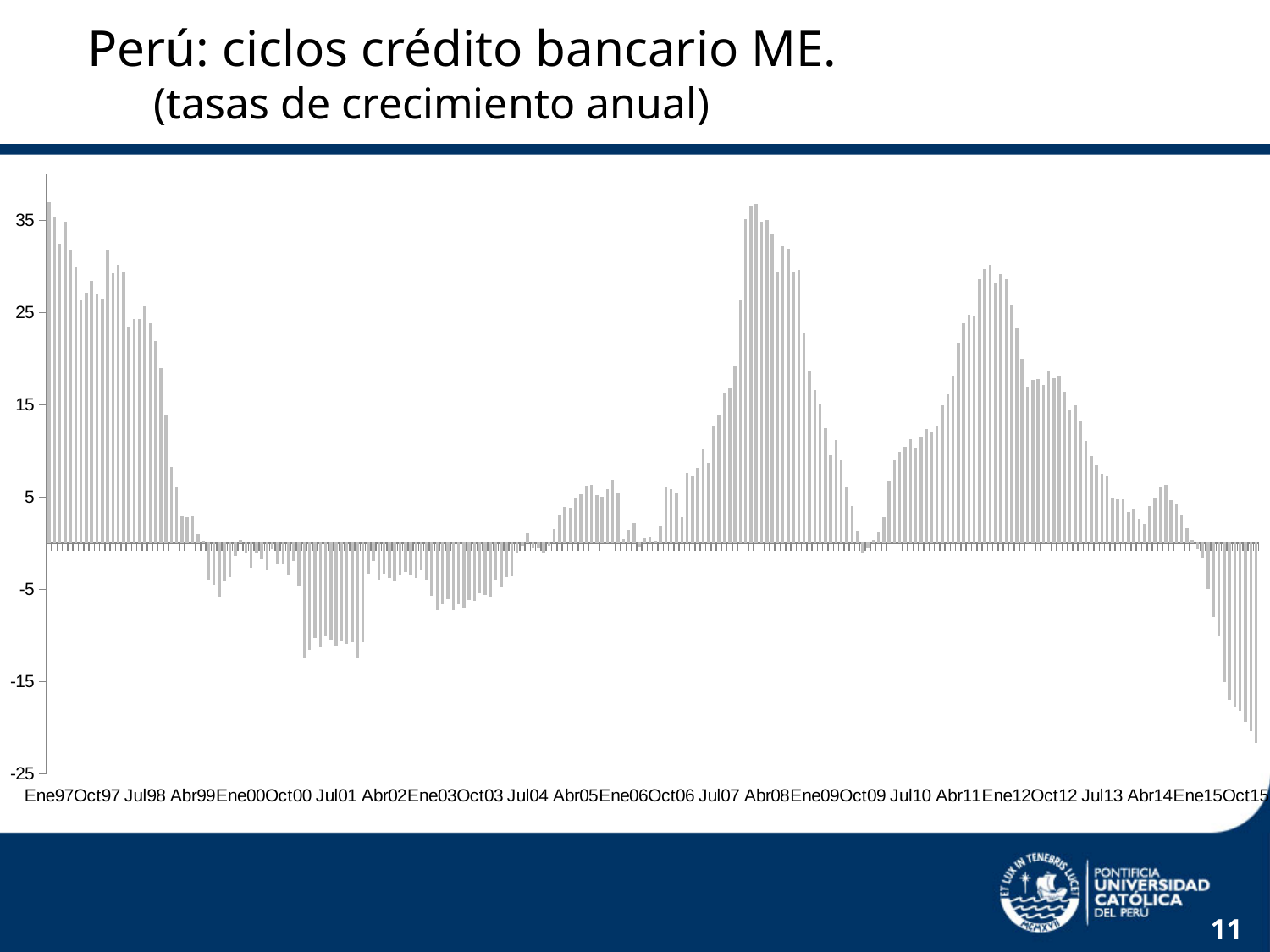
What kind of chart is shown on the slide? bar chart Which is larger, the value for Abr08 or the value for Jul07? Abr08 Is the value for Oct15 greater or less than -15? less What is the title of the chart on the slide? Perú: ciclos crédito bancario ME. (tasas de crecimiento anual) What is the highest value shown on the vertical axis of the chart? 35 Is the value for Abr08 greater or less than 25? greater Is the value for Ene97 greater or less than 25? greater Do the values rise or fall between Abr08 and Ene09? fall Which is lower, the value for Jul01 or the value for Oct15? Oct15